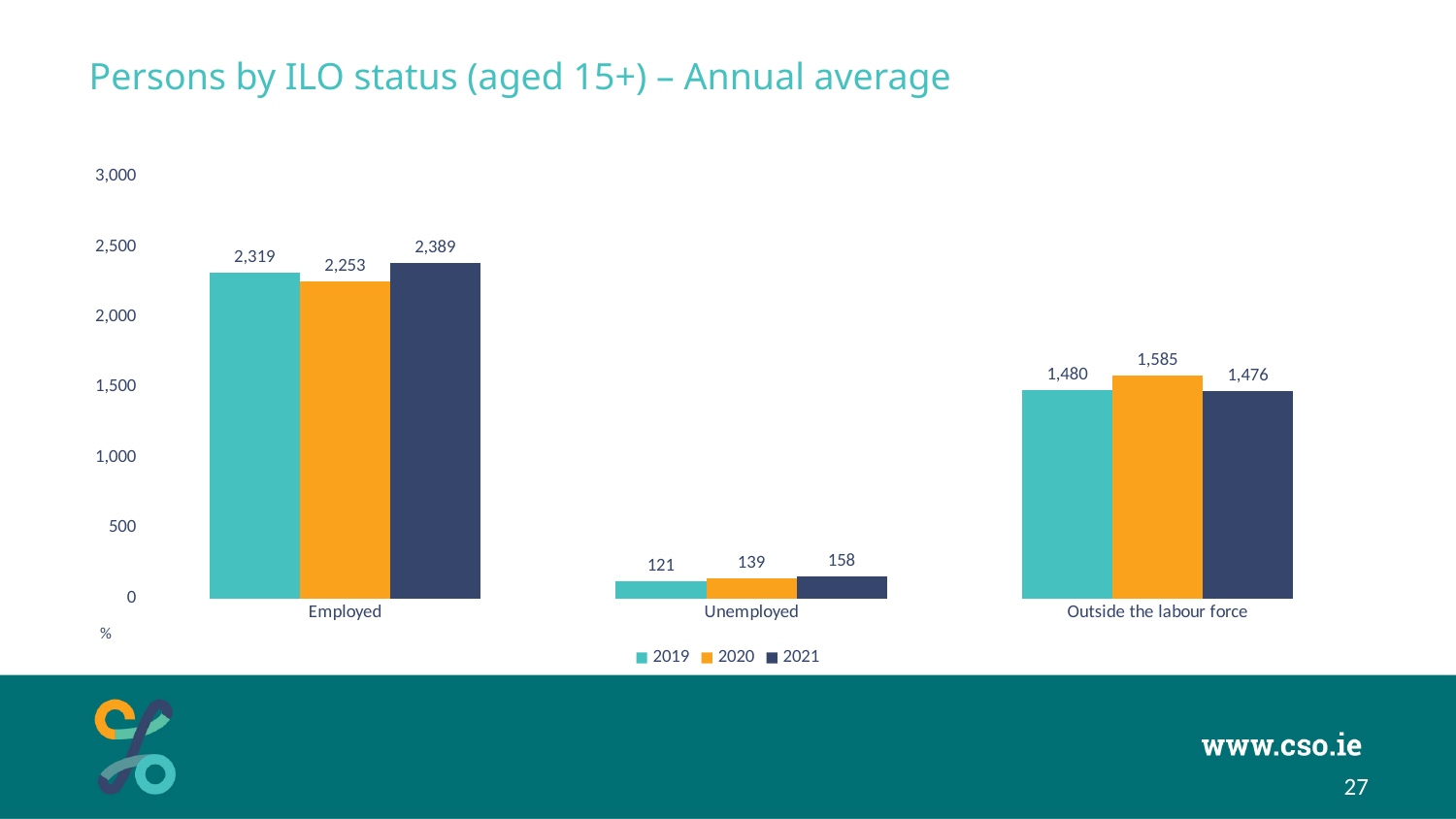
What is the difference between the Unemployed values for 2021 and 2019? 37 What is the value for Outside the labour force in 2020? 1,585 What is the value for Unemployed in 2019? 121 What is the value for Employed in 2021? 2,389 Which is larger: Employed in 2019 or Employed in 2020? Employed in 2019 Which year has the highest value for Employed? 2021 What kind of chart is shown on the slide? Bar chart What is the title of the chart? Persons by ILO status (aged 15+) – Annual average Which year has the lowest value for Outside the labour force? 2021 What is the difference between the Employed values for 2021 and 2020? 136 How many categories are shown on the x axis? 3 How many series does the legend list? 3